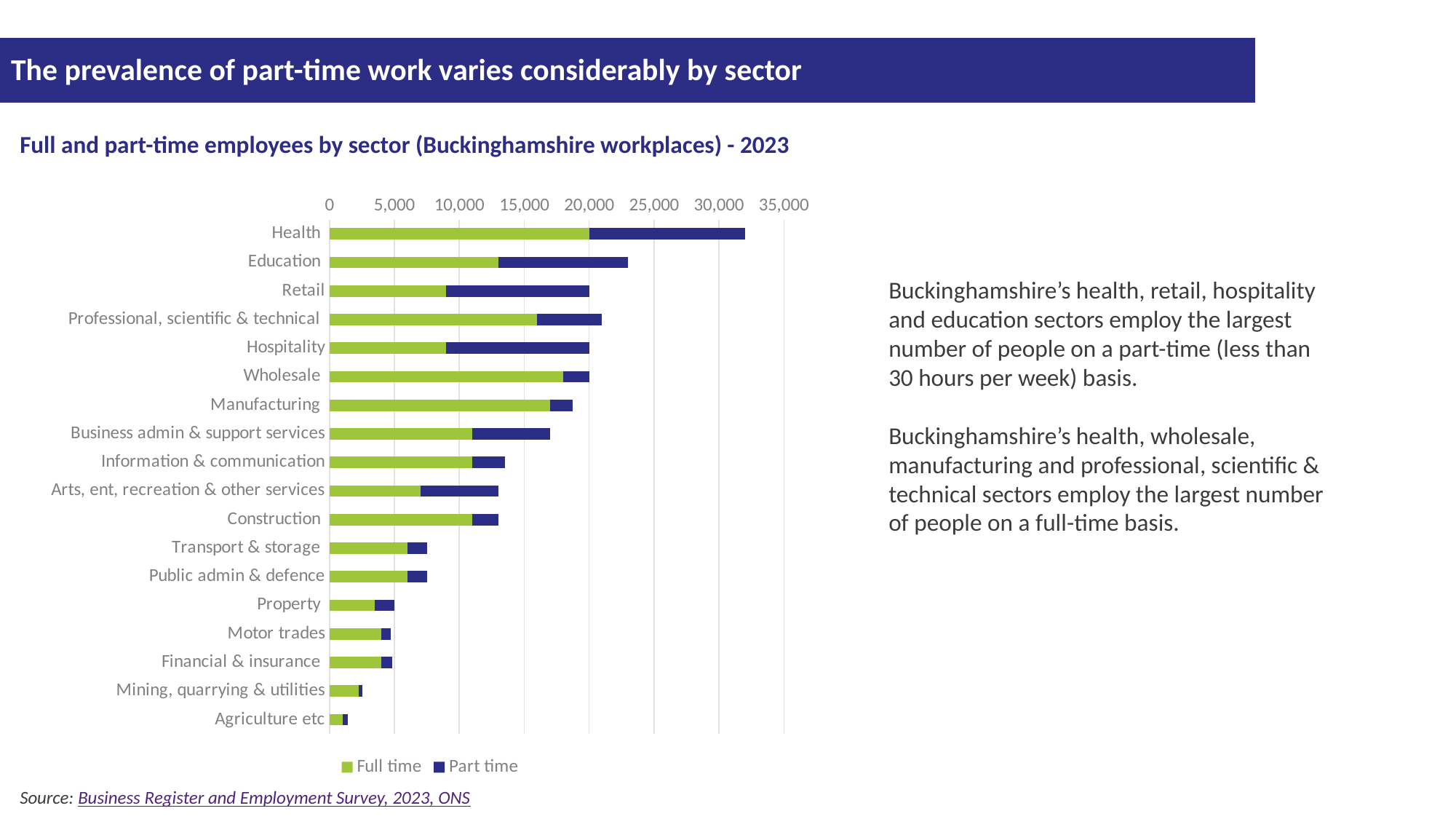
Which sector has the largest full-time segment? Health Is the total number of employees for Health greater or less than 30,000? greater Is the full-time value for Retail greater or less than 10,000? less Which sector has the shortest total bar (fewest employees overall)? Agriculture etc Which sector has the longest total bar (most employees overall)? Health Is the total number of employees for Education greater or less than 20,000? greater How many sectors are listed on the chart? 18 How many series does the legend list? 2 What is the title of the chart? Full and part-time employees by sector (Buckinghamshire workplaces) - 2023 Which has more full-time employees, Manufacturing or Retail? Manufacturing Which has more part-time employees, Retail or Manufacturing? Retail What kind of chart is shown on the slide? Stacked bar chart